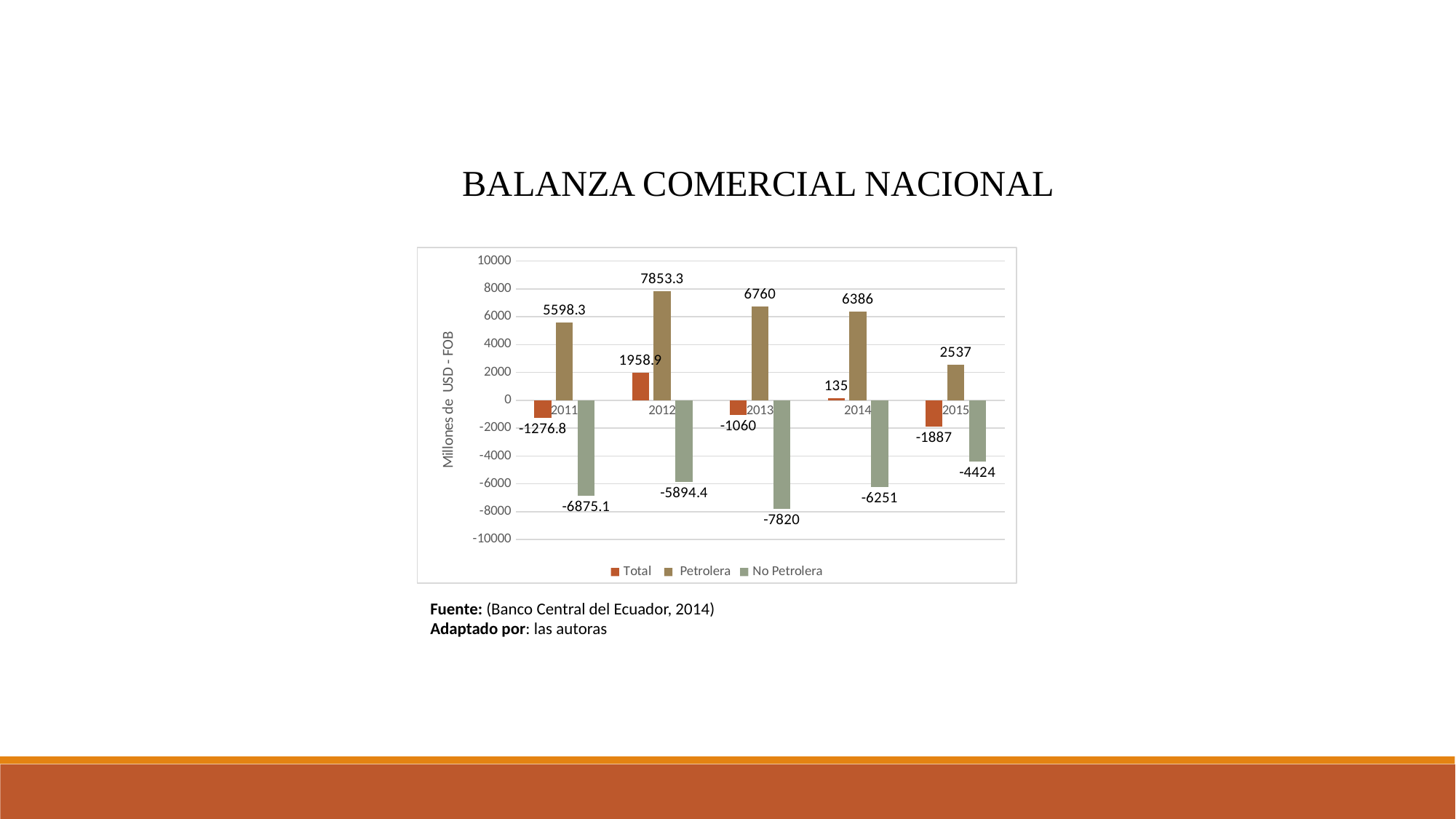
What is the difference between the Petrolera values for 2013 and 2014? 374 Which is larger, the Total value for 2012 or the Total value for 2015? 2012 What kind of chart is shown on the slide? bar chart In which year is the No Petrolera value lowest? 2013 What is the label of the vertical axis? Millones de USD - FOB In which year is the Petrolera value highest? 2012 How many years are shown on the x axis? 5 What is the Total value for 2014? 135 What is the No Petrolera value for 2013? -7820 What is the Total value for 2011? -1276.8 How many series does the legend list? 3 What is the Petrolera value for 2012? 7853.3